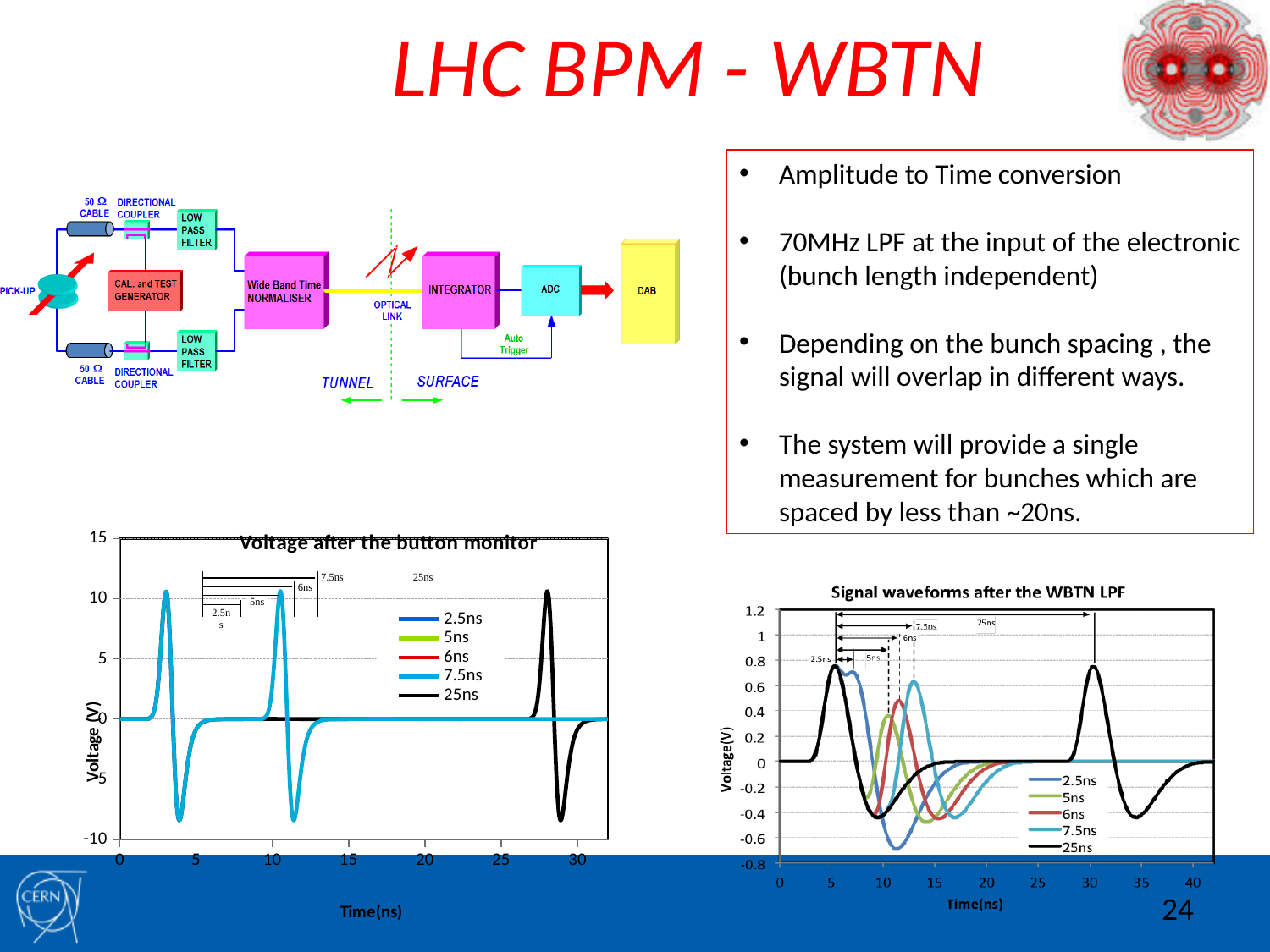
In the 'Voltage after the button monitor' chart, is the minimum value of the 25ns series greater or less than -5? less In the 'Signal waveforms after the WBTN LPF' chart, is the peak value of the 25ns series greater or less than 1? less How many series does the legend of the 'Signal waveforms after the WBTN LPF' chart list? 5 What is the title of the chart at the bottom right of the slide? Signal waveforms after the WBTN LPF What kind of chart is the 'Voltage after the button monitor' chart? line chart In the 'Signal waveforms after the WBTN LPF' chart, what colour is the 25ns series drawn in? black How many series does the legend of the 'Voltage after the button monitor' chart list? 5 In the 'Signal waveforms after the WBTN LPF' chart, which series has the higher peak, 25ns or 6ns? 25ns What kind of chart is the 'Signal waveforms after the WBTN LPF' chart? line chart In the 'Signal waveforms after the WBTN LPF' chart, is the peak value of the 25ns series greater or less than 0.6? greater